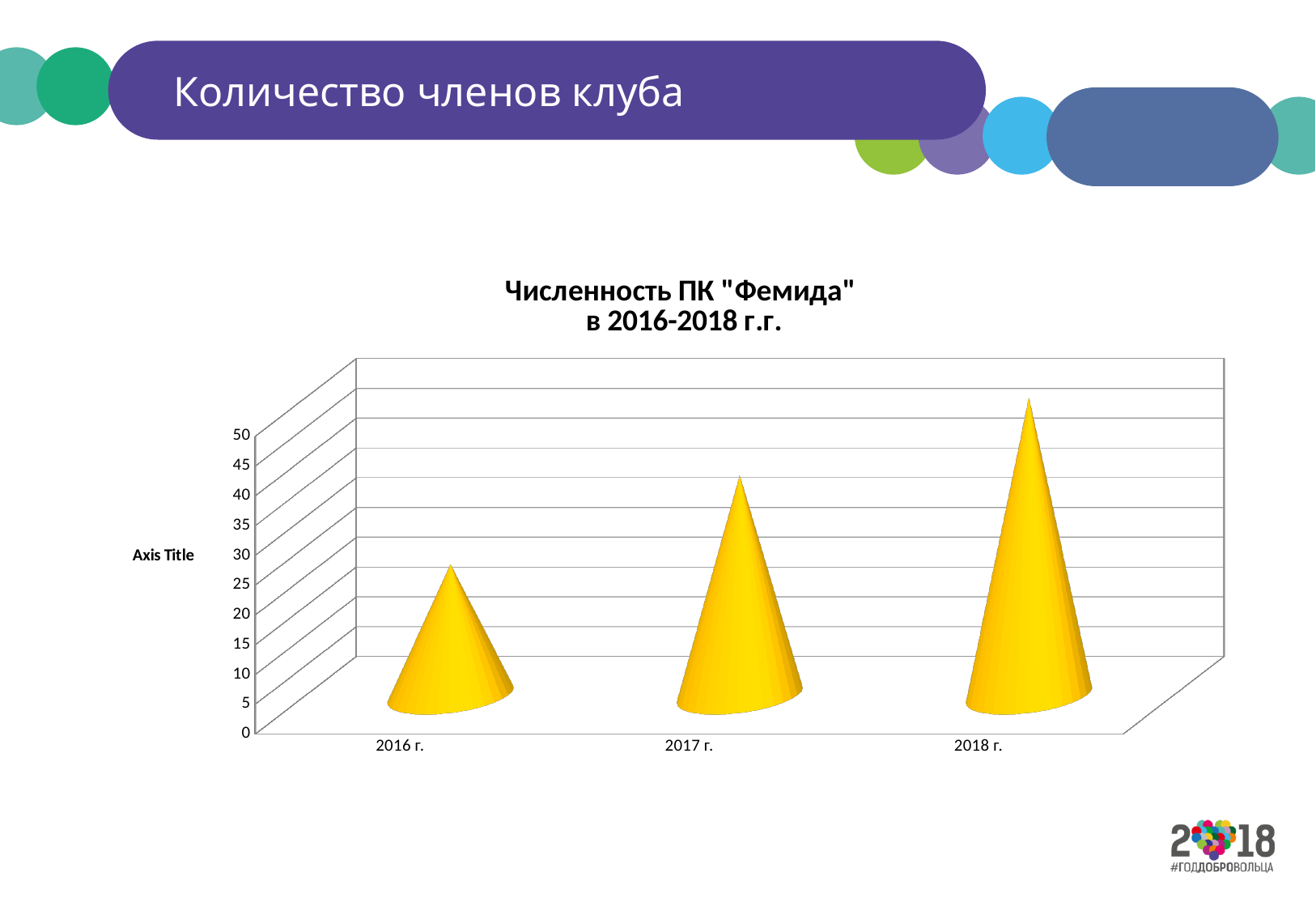
Do the values rise or fall from 2016 г. to 2018 г.? rise What kind of chart is shown on the slide? bar chart Which is larger, the value for 2018 г. or the value for 2017 г.? 2018 г. Which is larger, the value for 2017 г. or the value for 2016 г.? 2017 г. Is the value for 2017 г. greater or less than 30? greater What is the title of the chart? Численность ПК "Фемида" в 2016-2018 г.г. What is the label shown on the vertical axis of the chart? Axis Title Which year has the lowest value on the chart? 2016 г. Is the value for 2016 г. greater or less than 35? less Is the value for 2018 г. greater or less than 40? greater Which year has the highest value on the chart? 2018 г. How many categories (years) are plotted on the chart? 3